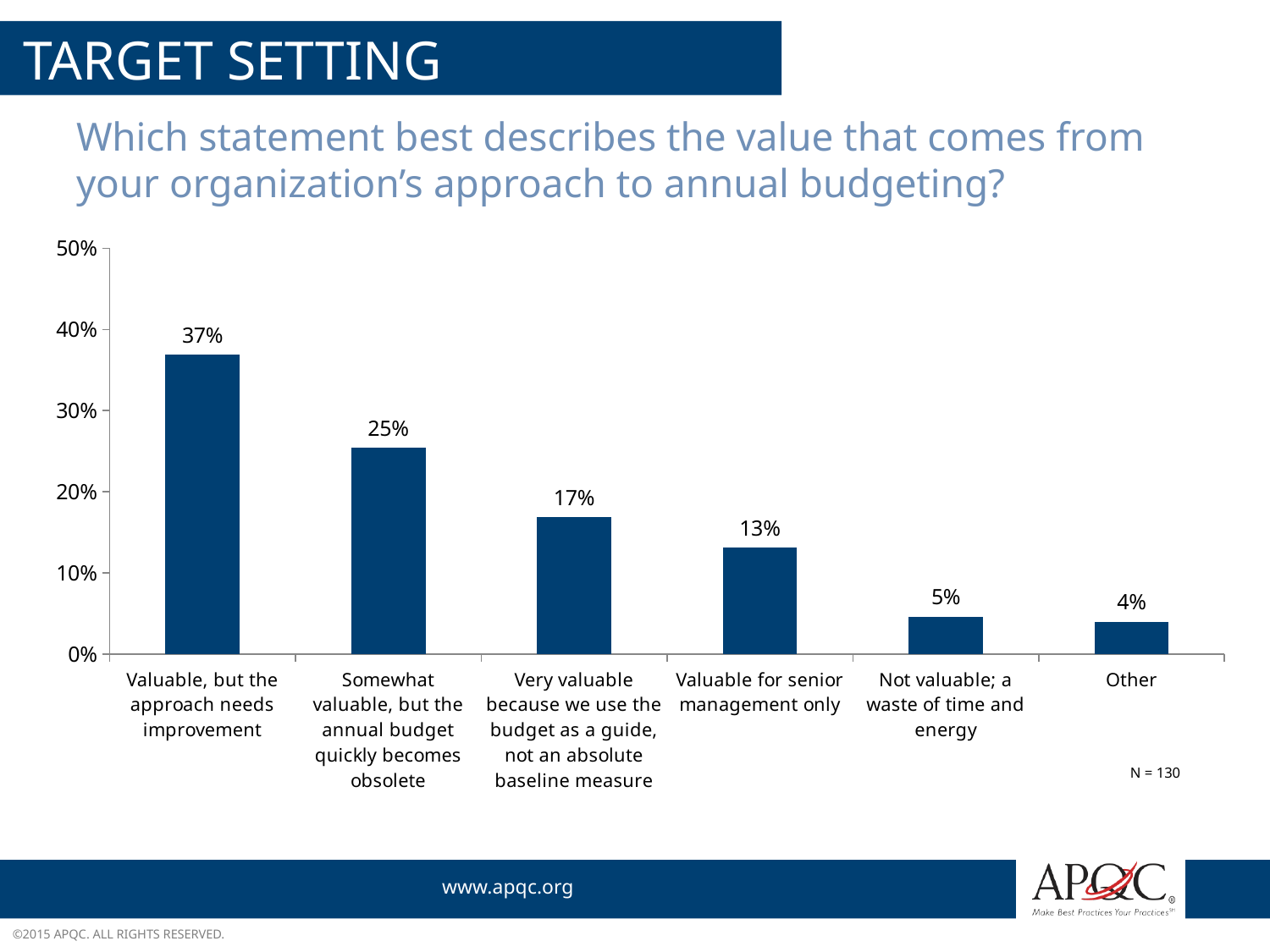
Is the value for "Somewhat valuable, but the annual budget quickly becomes obsolete" greater or less than 20%? greater What type of chart is shown on the slide? Bar chart What is the sample size (N) noted on the chart? N = 130 Which statement received the lowest percentage of responses? Other What is the difference in percentage points between "Somewhat valuable, but the annual budget quickly becomes obsolete" and "Very valuable because we use the budget as a guide, not an absolute baseline measure"? 8 percentage points What percentage of respondents chose "Valuable for senior management only"? 13% Which has a larger share: "Valuable for senior management only" or "Not valuable; a waste of time and energy"? Valuable for senior management only How many statement categories are shown on the chart? 6 Do the values rise or fall moving from left to right across the categories? Fall Which statement received the highest percentage of responses? Valuable, but the approach needs improvement What percentage of respondents chose "Not valuable; a waste of time and energy"? 5% What percentage of respondents chose "Valuable, but the approach needs improvement"? 37%